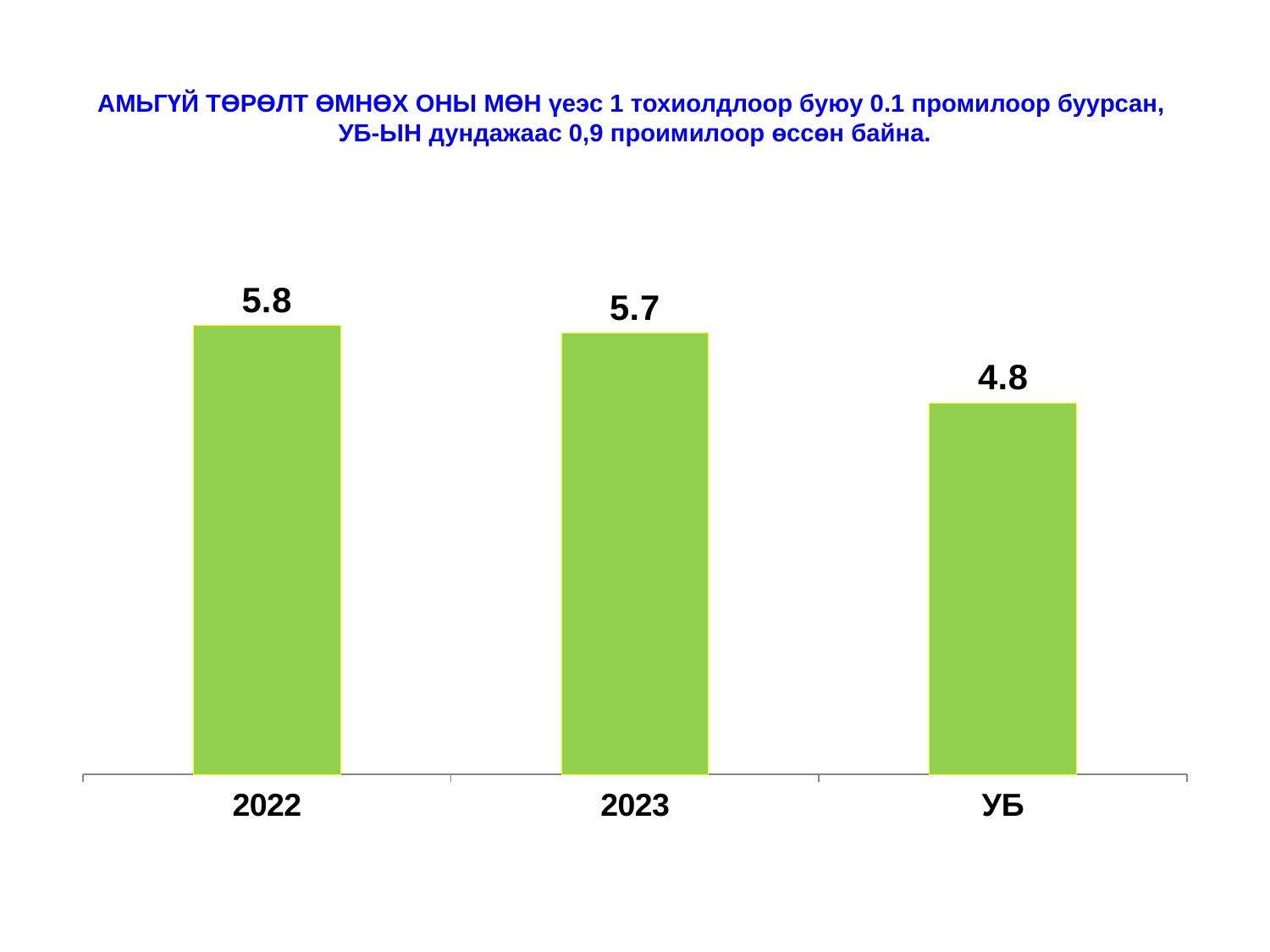
What is the value for УБ? 4.8 What kind of chart is shown on the slide? bar chart Which is larger, the value for 2023 or the value for УБ? 2023 What is the difference between the values for 2022 and 2023? 0.1 What is the value for 2023? 5.7 What colour are the bars in the chart? green Which category has the lowest value? УБ What is the value for 2022? 5.8 How many bars are shown in the chart? 3 Do the values rise or fall from 2022 to 2023? fall Which category has the highest value? 2022 What is the difference between the values for 2023 and УБ? 0.9